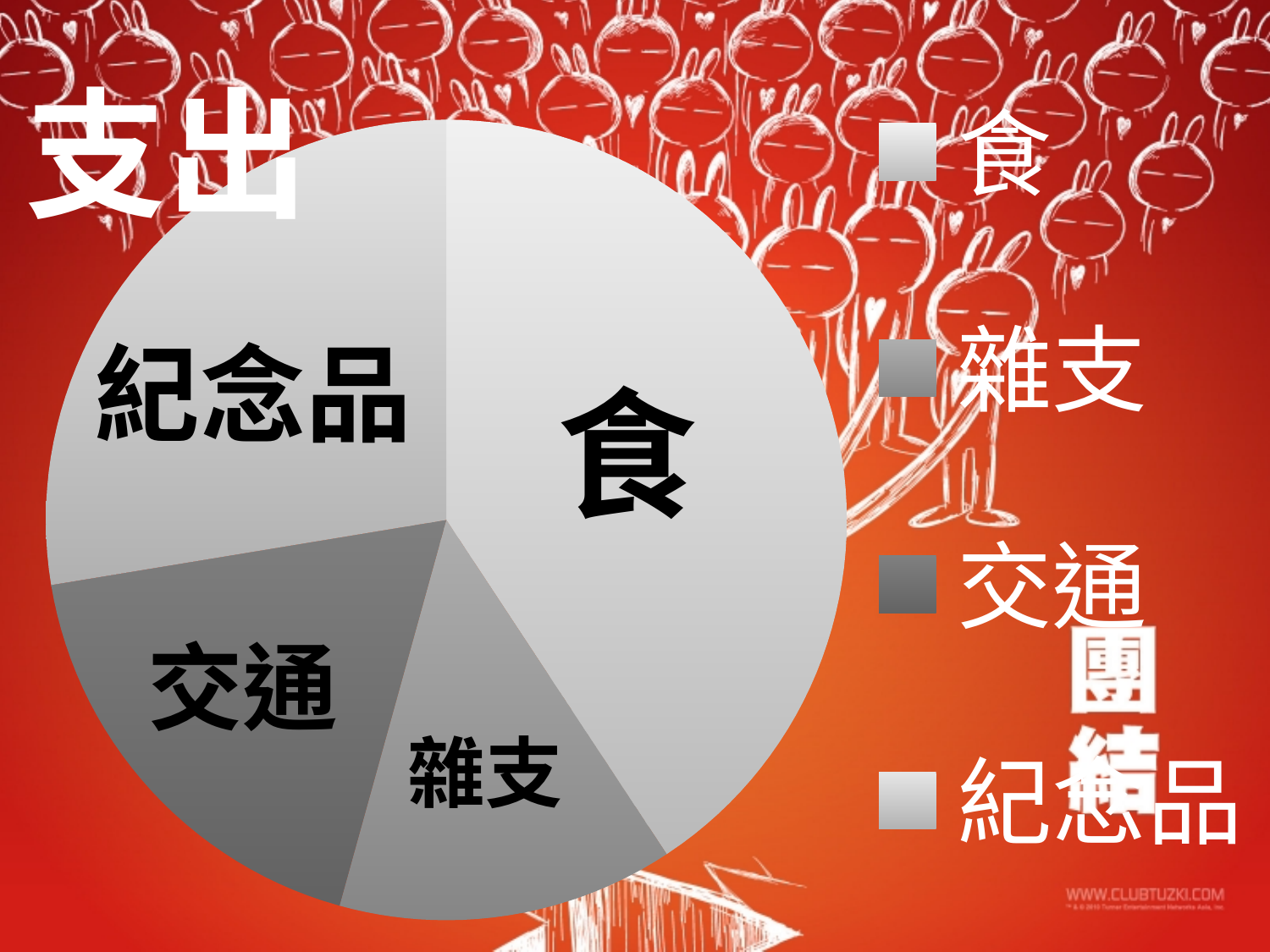
How many entries does the legend list? 4 Which category is listed first in the legend? 食 Which slice is larger, 食 or 紀念品? 食 Which slice is larger, 交通 or 雜支? 交通 Which category has the largest slice of the pie? 食 Which slice is larger, 紀念品 or 交通? 紀念品 What is the title of the chart? 支出 How many slices does the pie chart have? 4 What kind of chart is shown on the slide? pie chart Which category has the smallest slice of the pie? 雜支